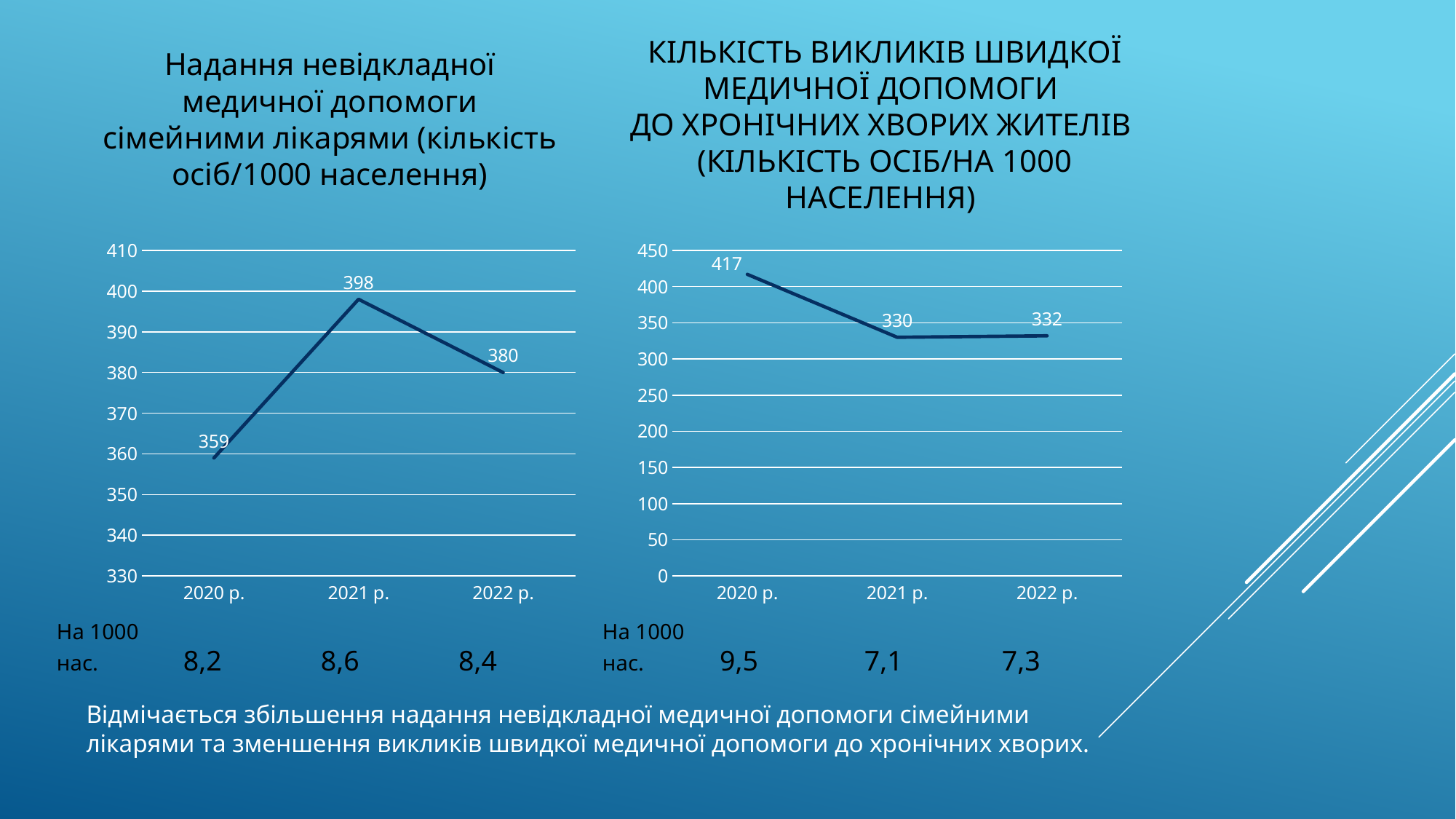
In the right chart, does the value rise or fall from 2020 р. to 2021 р.? Fall What type of chart is the left chart? Line chart In the left chart (emergency care by family doctors), what is the value for 2020 р.? 359 In the right chart, which year has the lowest value? 2021 р. In the left chart (emergency care by family doctors), what is the value for 2021 р.? 398 In the right chart, what is the difference between the 2020 р. and 2021 р. values? 87 In the right chart (ambulance calls to chronically ill residents), what is the value for 2022 р.? 332 In the right chart (ambulance calls to chronically ill residents), what is the value for 2020 р.? 417 How many data points are plotted in the right chart? 3 In the left chart, which is larger: the value for 2022 р. or the value for 2020 р.? 2022 р. In the left chart, what is the difference between the 2021 р. and 2020 р. values? 39 In the left chart, which year has the highest value? 2021 р.